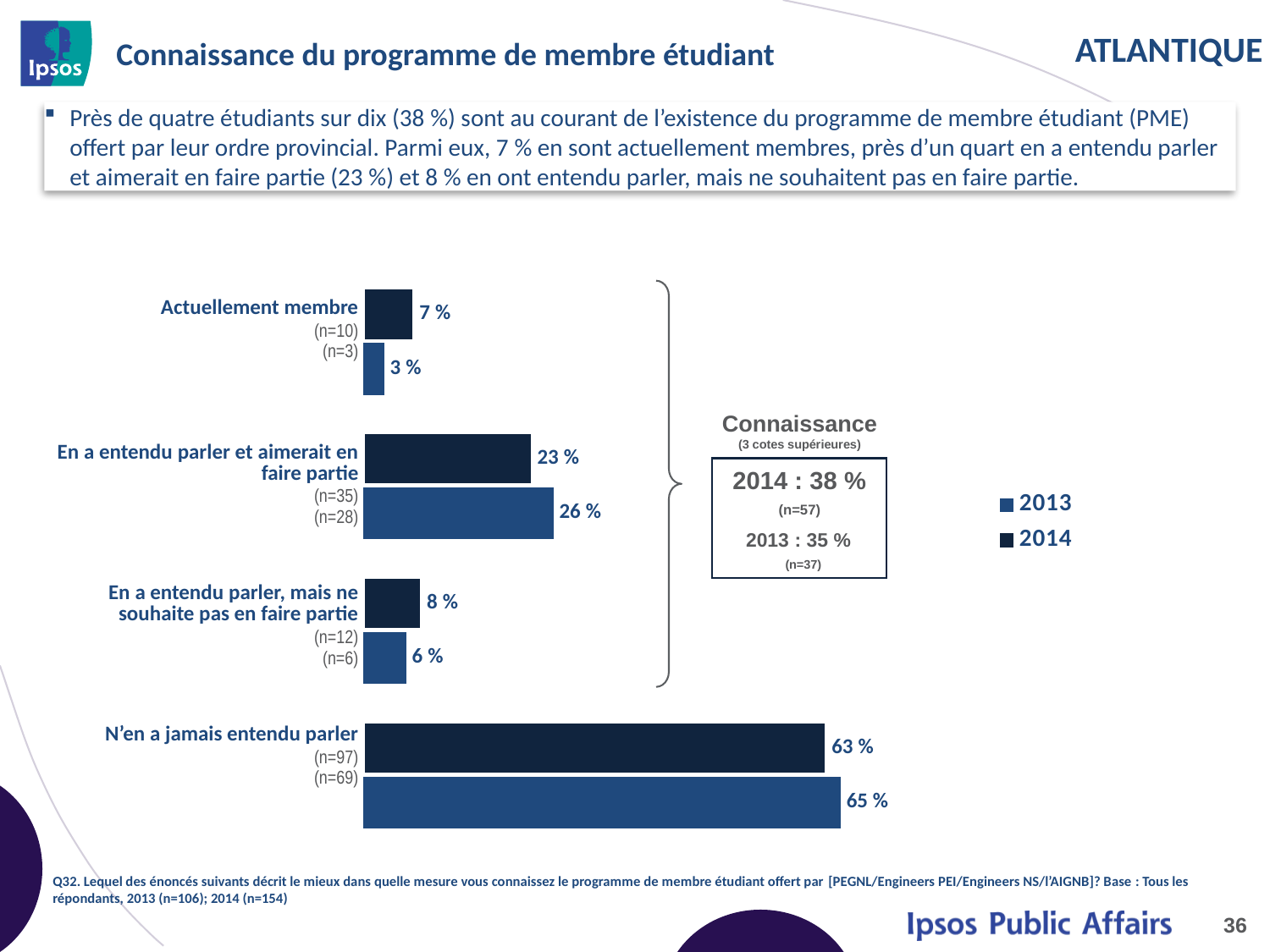
What is the value of the lighter blue (lower) bar for 'En a entendu parler et aimerait en faire partie'? 26 % What is the value of the lighter blue (lower) bar for 'N'en a jamais entendu parler'? 65 % How many series does the chart legend list? 2 In the 'Connaissance' box, what is the value shown for 2014? 38 % Which category has the lowest value in the chart? Actuellement membre What are the two entries in the chart legend? 2013 and 2014 For 'En a entendu parler, mais ne souhaite pas en faire partie', which bar is larger, the dark navy (upper) bar or the lighter blue (lower) bar? The dark navy (upper) bar How many categories are plotted in the bar chart? 4 What kind of chart is shown on the slide? Bar chart Which category has the highest values in the chart? N'en a jamais entendu parler What is the difference between the two bars for 'En a entendu parler et aimerait en faire partie'? 3 % What is the value of the dark navy (upper) bar for 'Actuellement membre'? 7 %